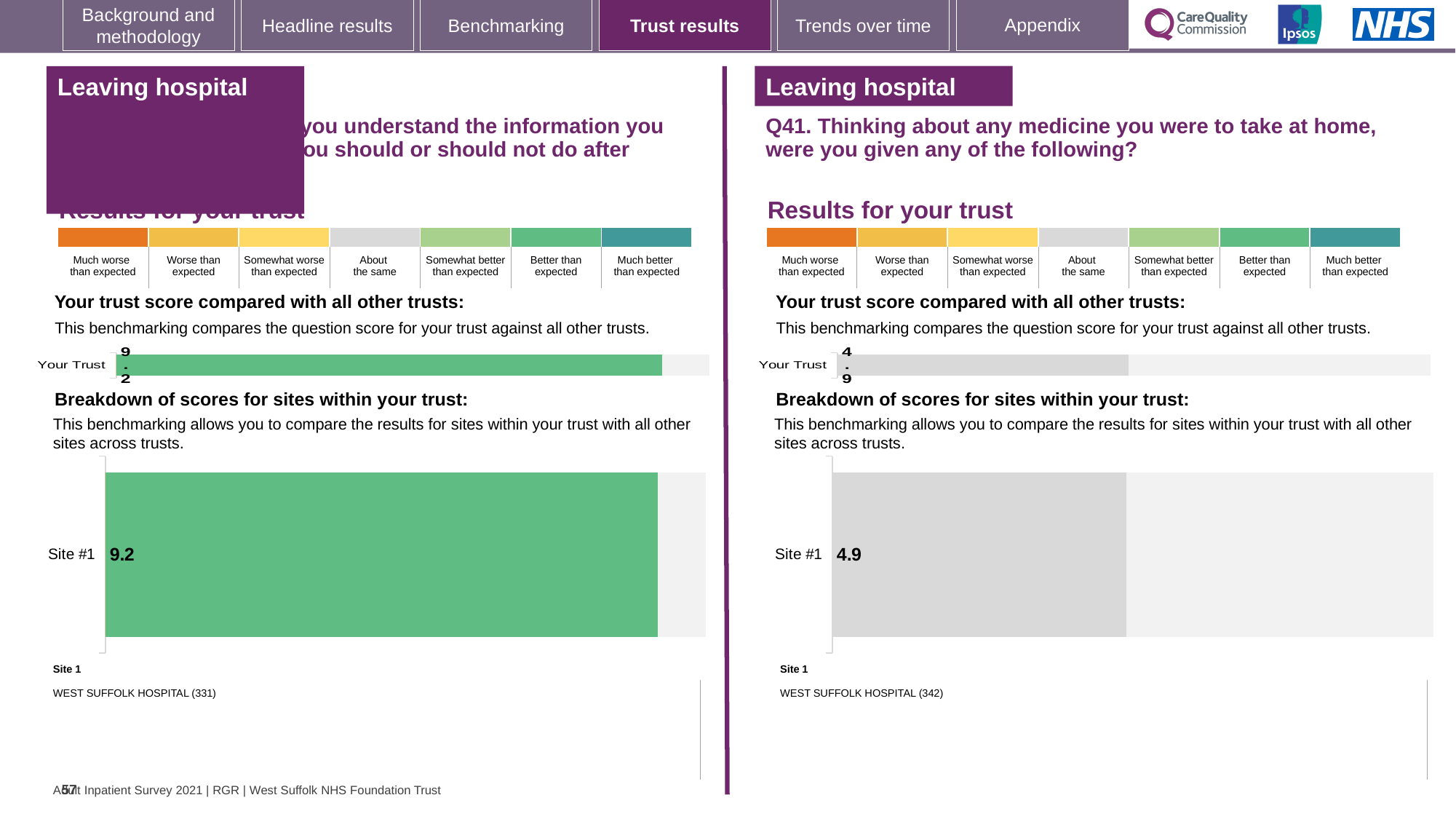
On the right-hand (Q41) 'Breakdown of scores for sites within your trust' chart, what is the value for Site #1? 4.9 Which is larger: the Site #1 score on the left-hand breakdown chart or the Site #1 score on the right-hand (Q41) breakdown chart? Left-hand chart (9.2) On the right-hand (Q41) 'Your trust score compared with all other trusts' chart, what is the value for Your Trust? 4.9 Which site name is listed as Site 1 beneath the right-hand (Q41) breakdown chart? WEST SUFFOLK HOSPITAL (342) How many sites are shown on the left-hand 'Breakdown of scores for sites within your trust' chart? 1 According to the colour key, which benchmark category does the grey colour of the Site #1 bar on the right-hand (Q41) breakdown chart represent? About the same On the left-hand 'Your trust score compared with all other trusts' chart, what is the value for Your Trust? 9.2 What type of chart is used to show the Site #1 score on the right-hand (Q41) breakdown chart? Bar chart On the left-hand 'Breakdown of scores for sites within your trust' chart, what is the value for Site #1? 9.2 What is the difference between the Site #1 score on the left-hand breakdown chart (9.2) and the Site #1 score on the right-hand (Q41) breakdown chart (4.9)? 4.3 According to the colour key, which benchmark category does the green colour of the Site #1 bar on the left-hand breakdown chart represent? Better than expected How many sites are shown on the right-hand (Q41) 'Breakdown of scores for sites within your trust' chart? 1